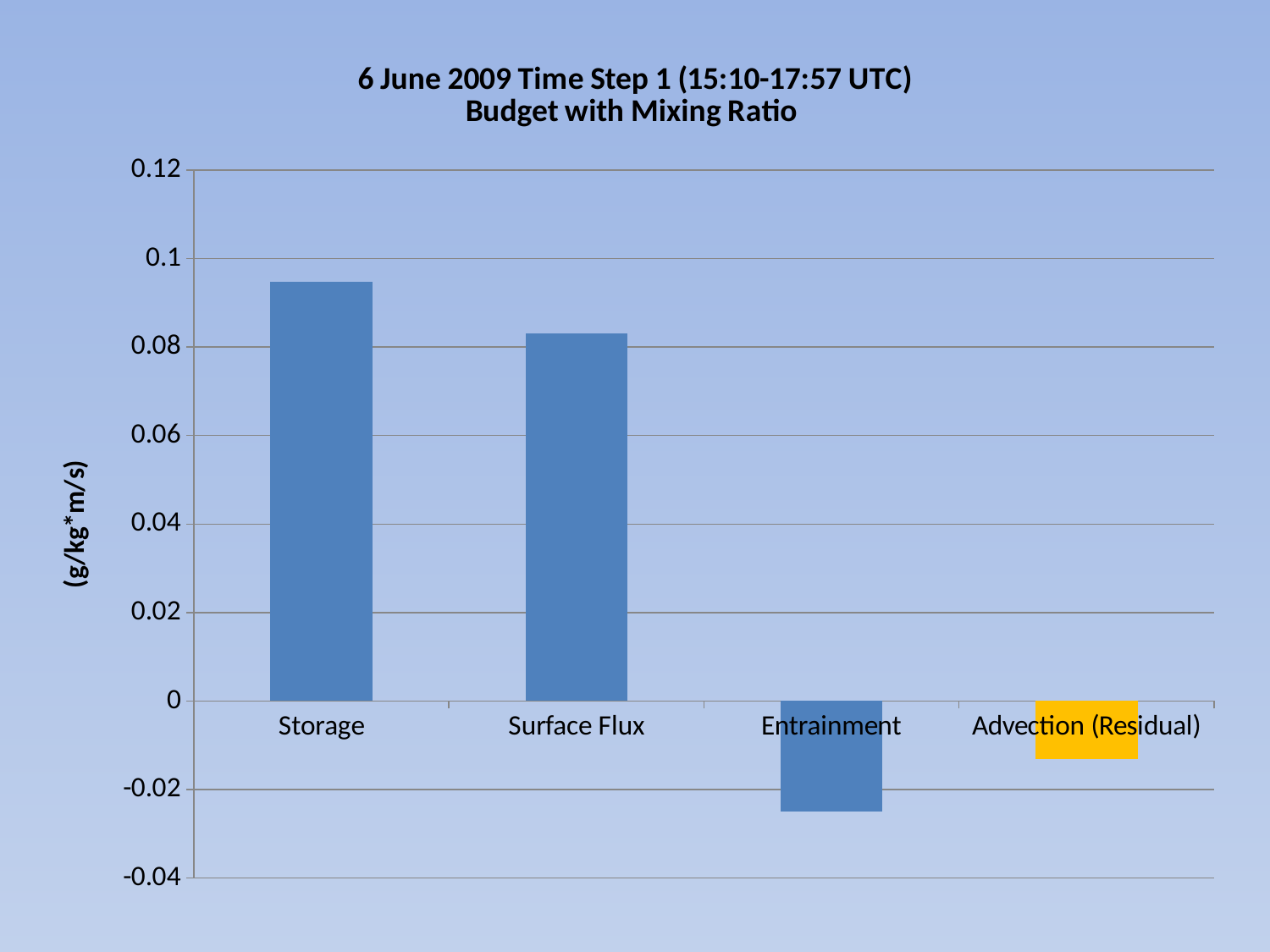
What is the label on the vertical axis? (g/kg*m/s) Which is larger, the value for Entrainment or the value for Advection (Residual)? Advection (Residual) How many categories are plotted on the x axis? 4 Which category's bar is coloured differently (orange) from the others? Advection (Residual) Which is larger, the value for Storage or the value for Surface Flux? Storage Is the value for Entrainment greater or less than -0.02? less Which category has the highest value? Storage Is the value for Storage greater or less than 0.08? greater Is the value for Surface Flux greater or less than 0.1? less What kind of chart is shown on the slide? bar chart Which category has the lowest value? Entrainment